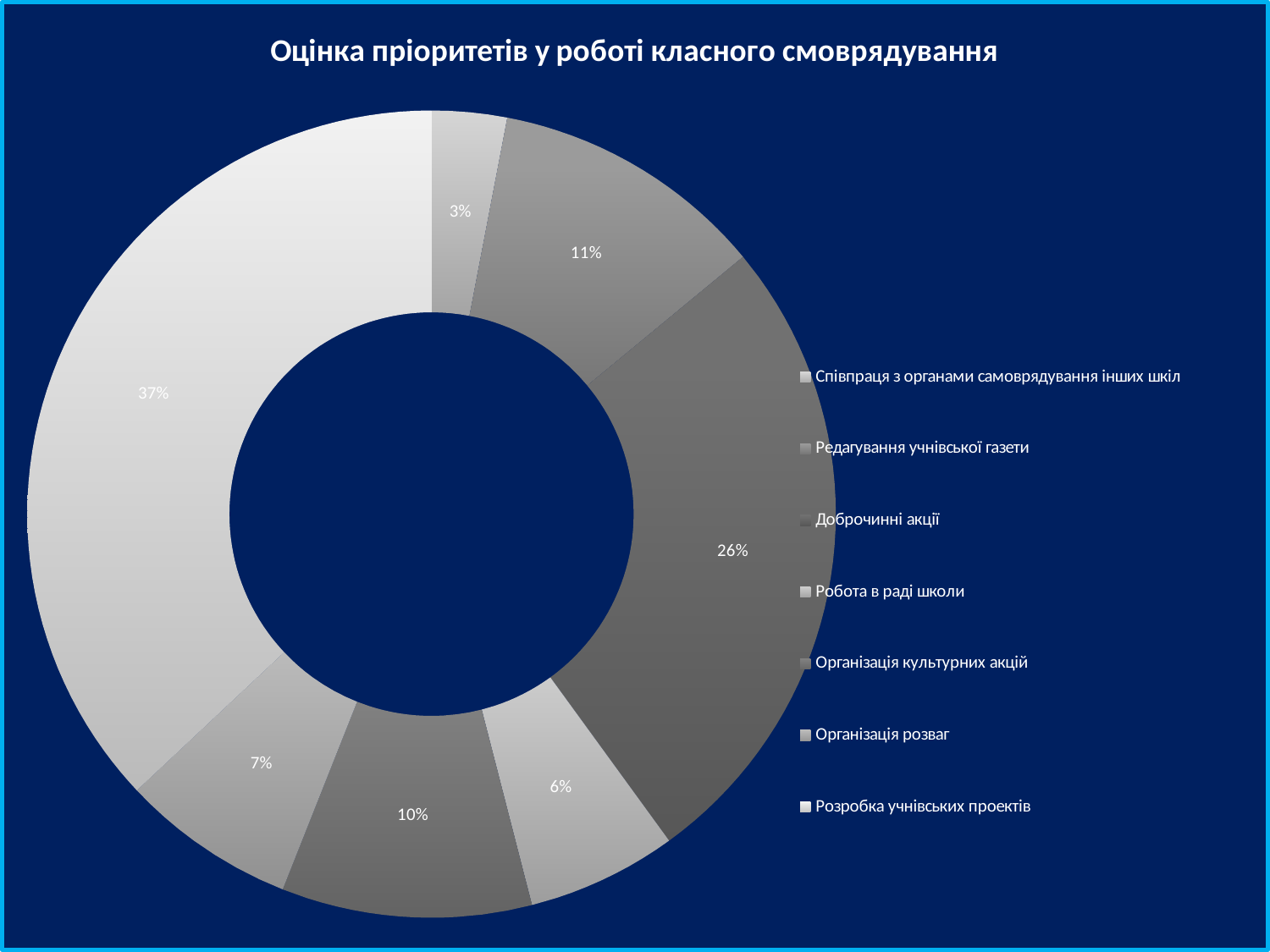
Which is larger, the 11% slice or the 10% slice? The 11% slice What is the title of the chart? Оцінка пріоритетів у роботі класного смоврядування What is the difference between the largest slice (37%) and the second largest slice (26%)? 11 percentage points What is the smallest percentage shown on the chart? 3% How many slices does the doughnut chart have? 7 What percentage is shown for Доброчинні акції? 26% How many entries does the legend list? 7 What kind of chart is shown on the slide? Doughnut (pie) chart What is the difference between the 10% slice and the 6% slice? 4 percentage points What percentage is shown for Співпраця з органами самоврядування інших шкіл? 3% What is the largest percentage shown on the chart? 37% What share of the chart does the slice for Розробка учнівських проектів take? 37%